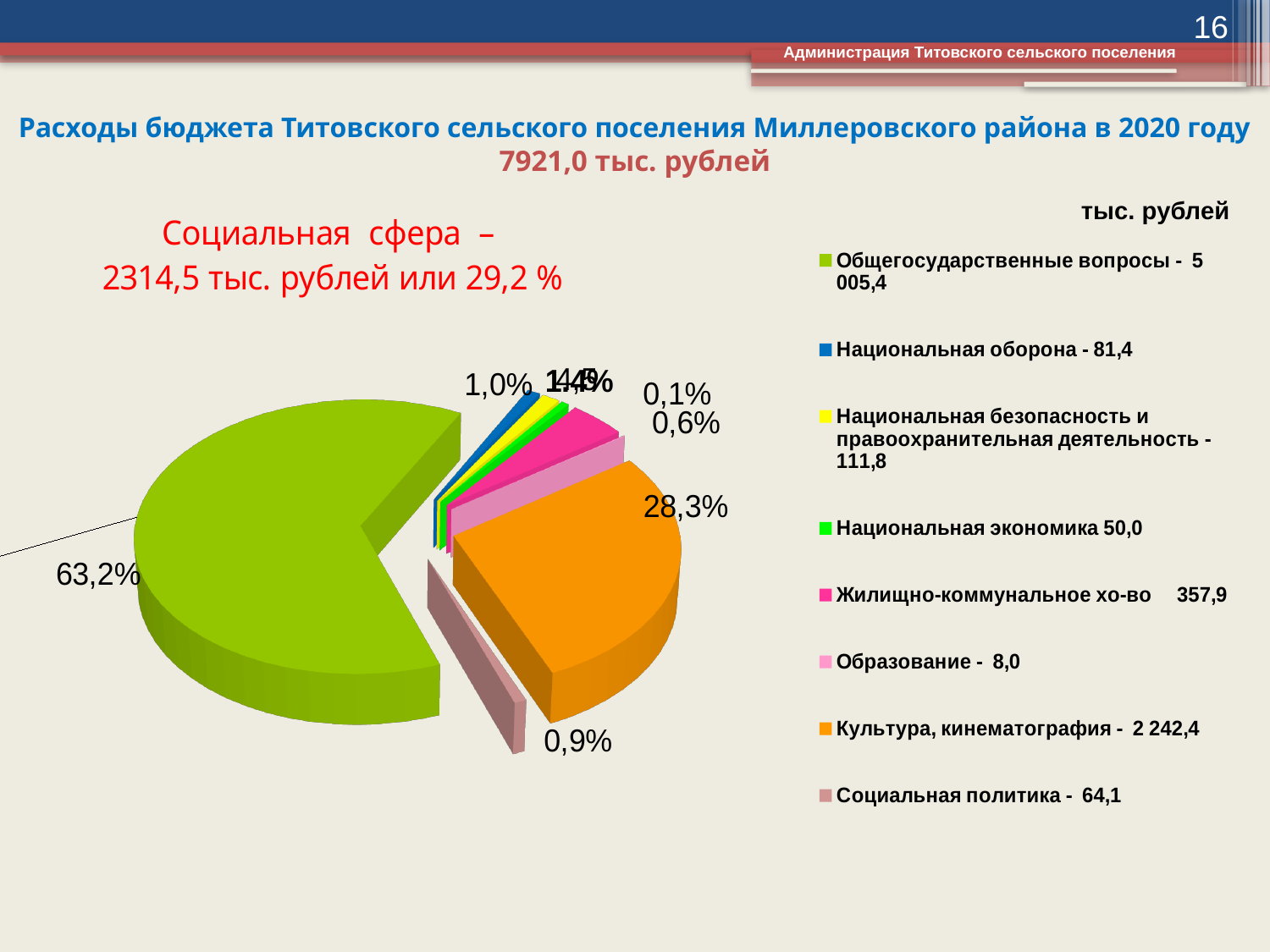
What value does the legend give for Жилищно-коммунальное хо-во? 357,9 Which category has the smallest value in the legend? Образование What share of the pie is labelled for the orange slice (Культура, кинематография)? 28,3% Which is larger: Национальная безопасность и правоохранительная деятельность or Национальная экономика? Национальная безопасность и правоохранительная деятельность What share of the pie is labelled for the largest (green) slice? 63,2% How many categories does the legend of the pie chart list? 8 What value does the legend give for Культура, кинематография? 2 242,4 What value (тыс. рублей) does the legend give for Общегосударственные вопросы? 5 005,4 What value does the legend give for Национальная оборона? 81,4 Which category has the largest slice of the pie? Общегосударственные вопросы What kind of chart is shown on the slide? pie chart What value does the legend give for Социальная политика? 64,1